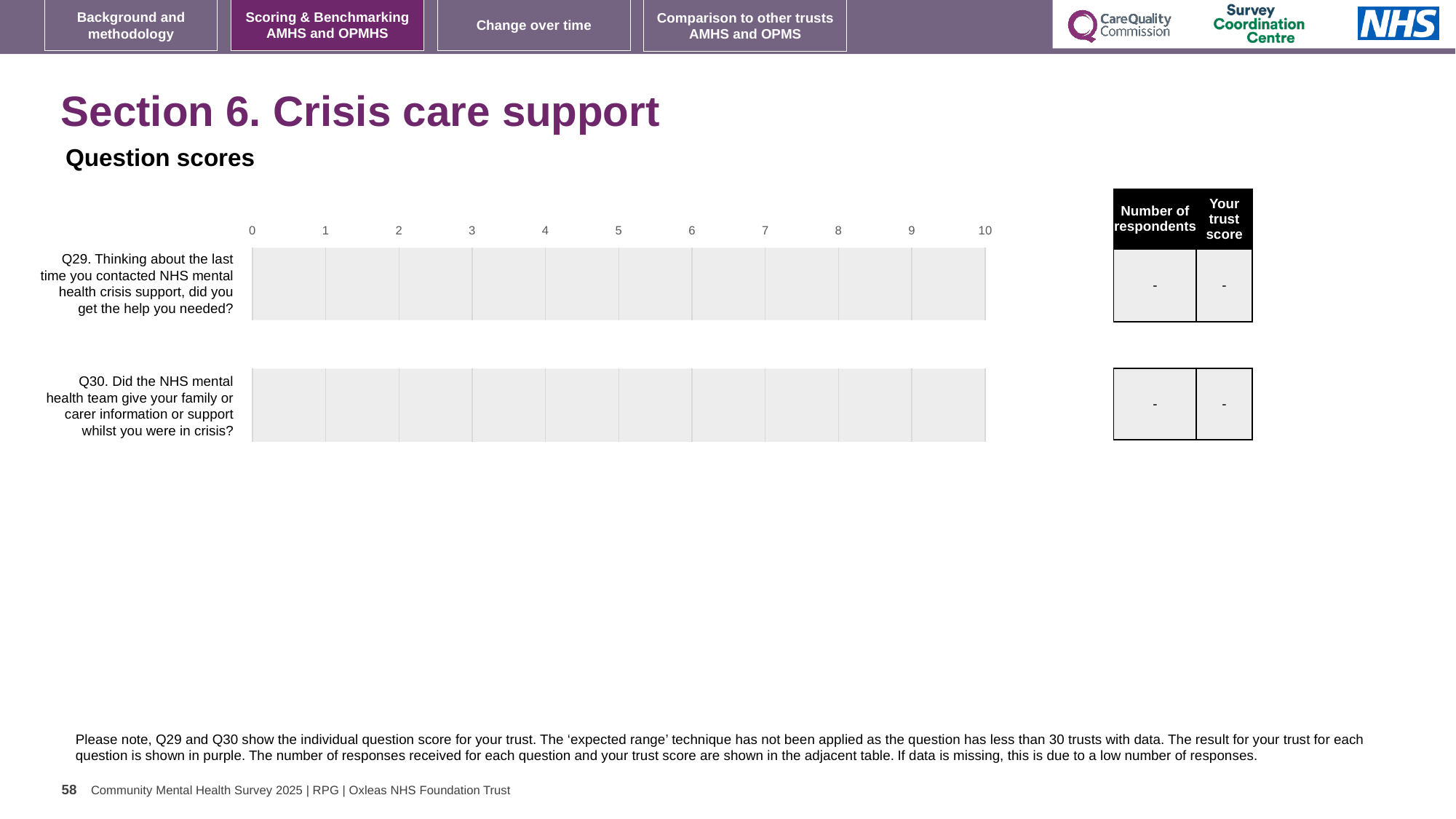
What is the 'Number of respondents' shown in the table for Q29? - What kind of chart is used for the Question scores on this slide? Bar chart How many questions are listed on the Question scores chart? 2 What is the 'Number of respondents' shown in the table for Q30? - What is the lowest value shown on the x axis of the Question scores chart? 0 What is the 'Your trust score' shown in the table for Q30? - What is the 'Your trust score' shown in the table for Q29? - What is the highest value shown on the x axis of the Question scores chart? 10